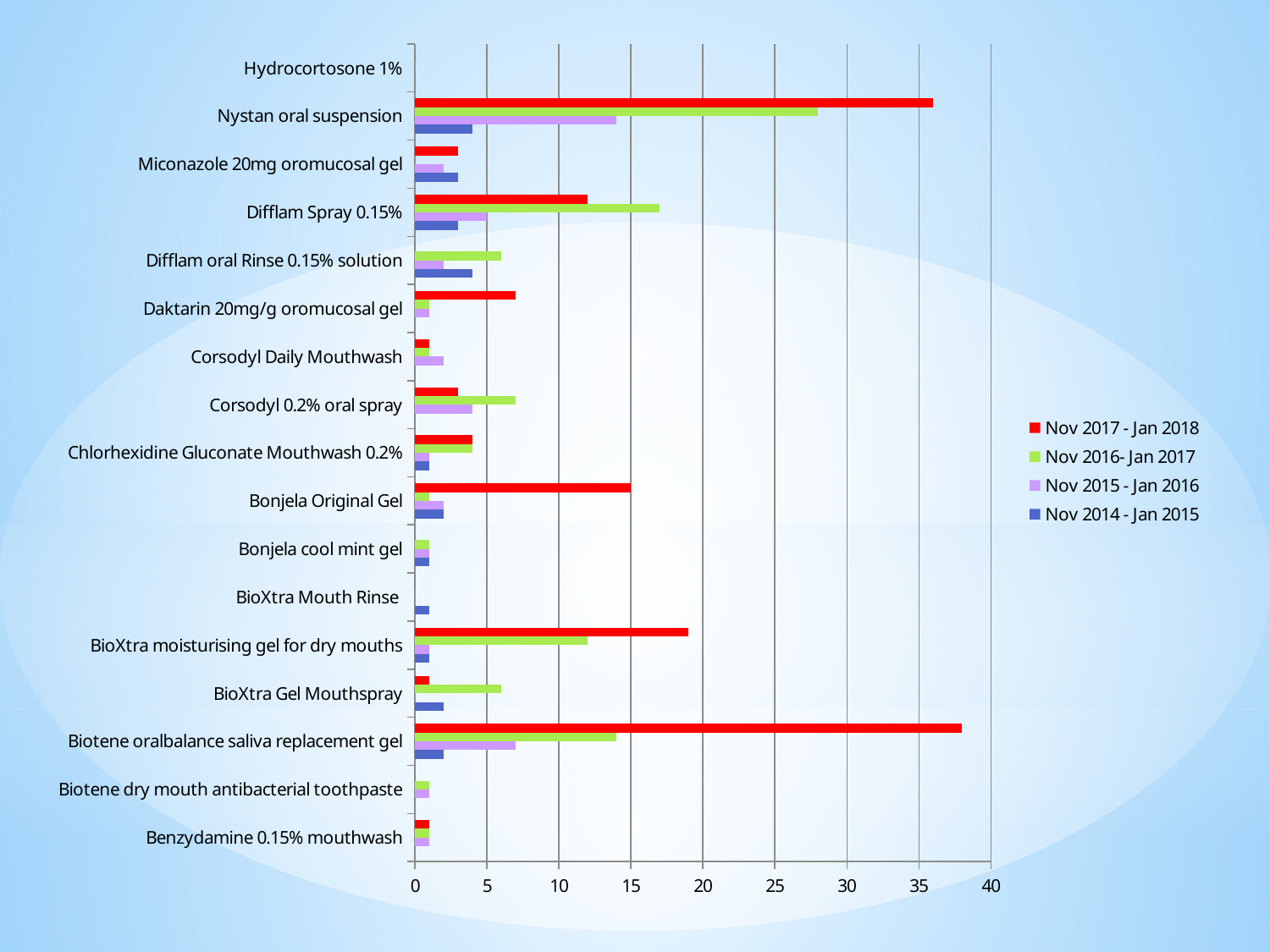
For Nov 2016- Jan 2017, which has the larger value: Nystan oral suspension or Biotene oralbalance saliva replacement gel? Nystan oral suspension Which product has the highest value for Nov 2017 - Jan 2018? Biotene oralbalance saliva replacement gel For Difflam Spray 0.15%, which series has the larger value: Nov 2017 - Jan 2018 or Nov 2016- Jan 2017? Nov 2016- Jan 2017 How many series does the legend list? 4 How many product categories are listed on the chart? 17 What colour represents the Nov 2017 - Jan 2018 series in the legend? red Is the value for Nystan oral suspension in Nov 2016- Jan 2017 greater or less than 25? greater Is the value for Nystan oral suspension in Nov 2017 - Jan 2018 greater or less than 35? greater Is the value for BioXtra moisturising gel for dry mouths in Nov 2017 - Jan 2018 greater or less than 20? less What kind of chart is shown on the slide? bar chart For Bonjela Original Gel, which series has the larger value: Nov 2017 - Jan 2018 or Nov 2016- Jan 2017? Nov 2017 - Jan 2018